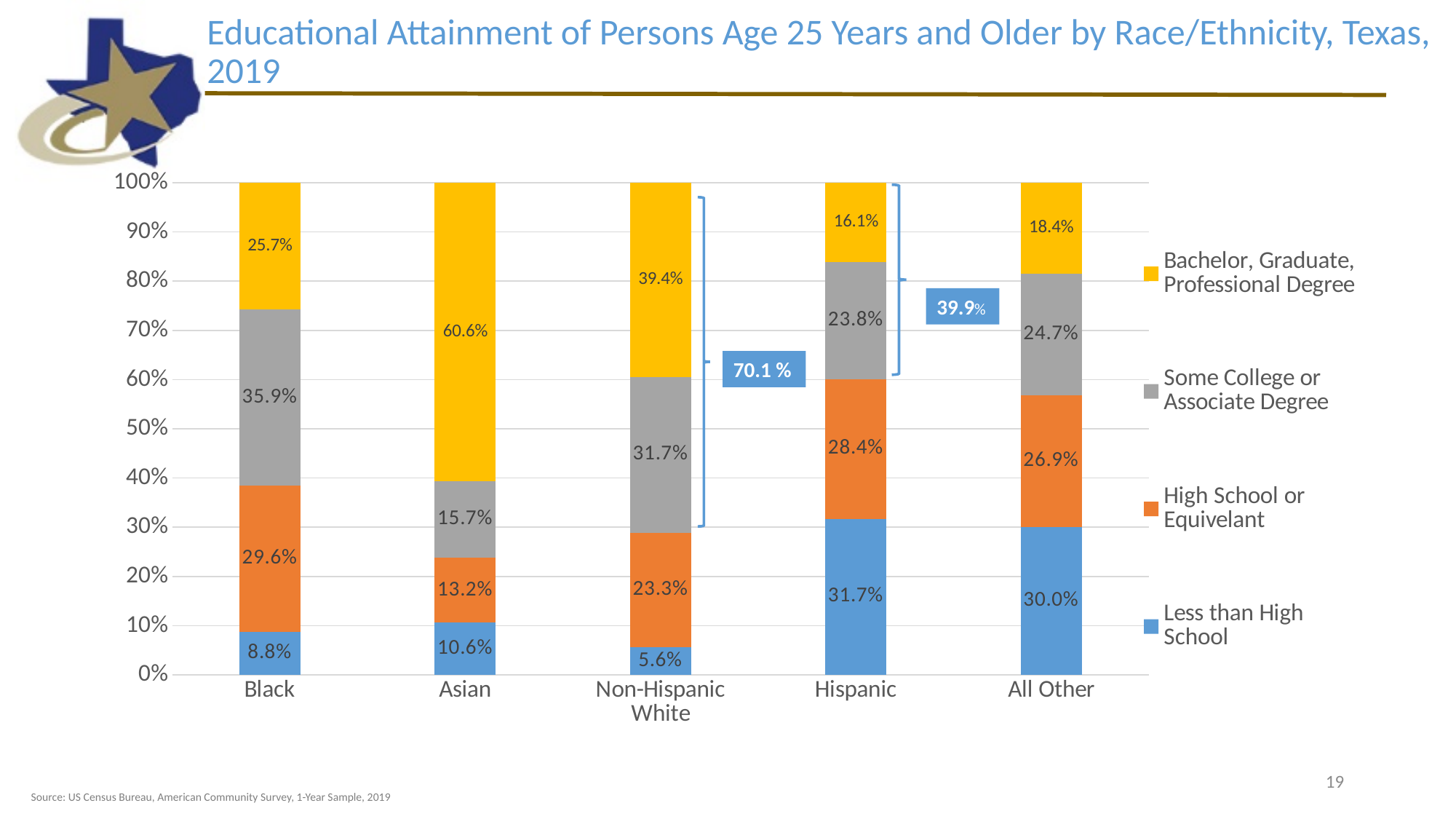
What is the Less than High School share for Hispanic persons? 31.7% Which race/ethnicity group has the lowest Less than High School share? Non-Hispanic White Which race/ethnicity group has the highest share with a Bachelor, Graduate, or Professional Degree? Asian What kind of chart is shown on the slide? Stacked bar chart How many race/ethnicity categories are shown on the x axis? 5 What percentage of Asians age 25 and older have a Bachelor, Graduate, or Professional Degree? 60.6% What is the combined share of Some College or Associate Degree and Bachelor, Graduate, Professional Degree for Hispanic persons? 39.9% Which is larger: the Some College or Associate Degree share for Black or for All Other? Black What is the High School or Equivelant share for Non-Hispanic White persons? 23.3% How many series does the legend list? 4 How many percentage points higher is the Bachelor, Graduate, Professional Degree share for Asian than for Black? 34.9 percentage points What is the Some College or Associate Degree share for Black persons? 35.9%